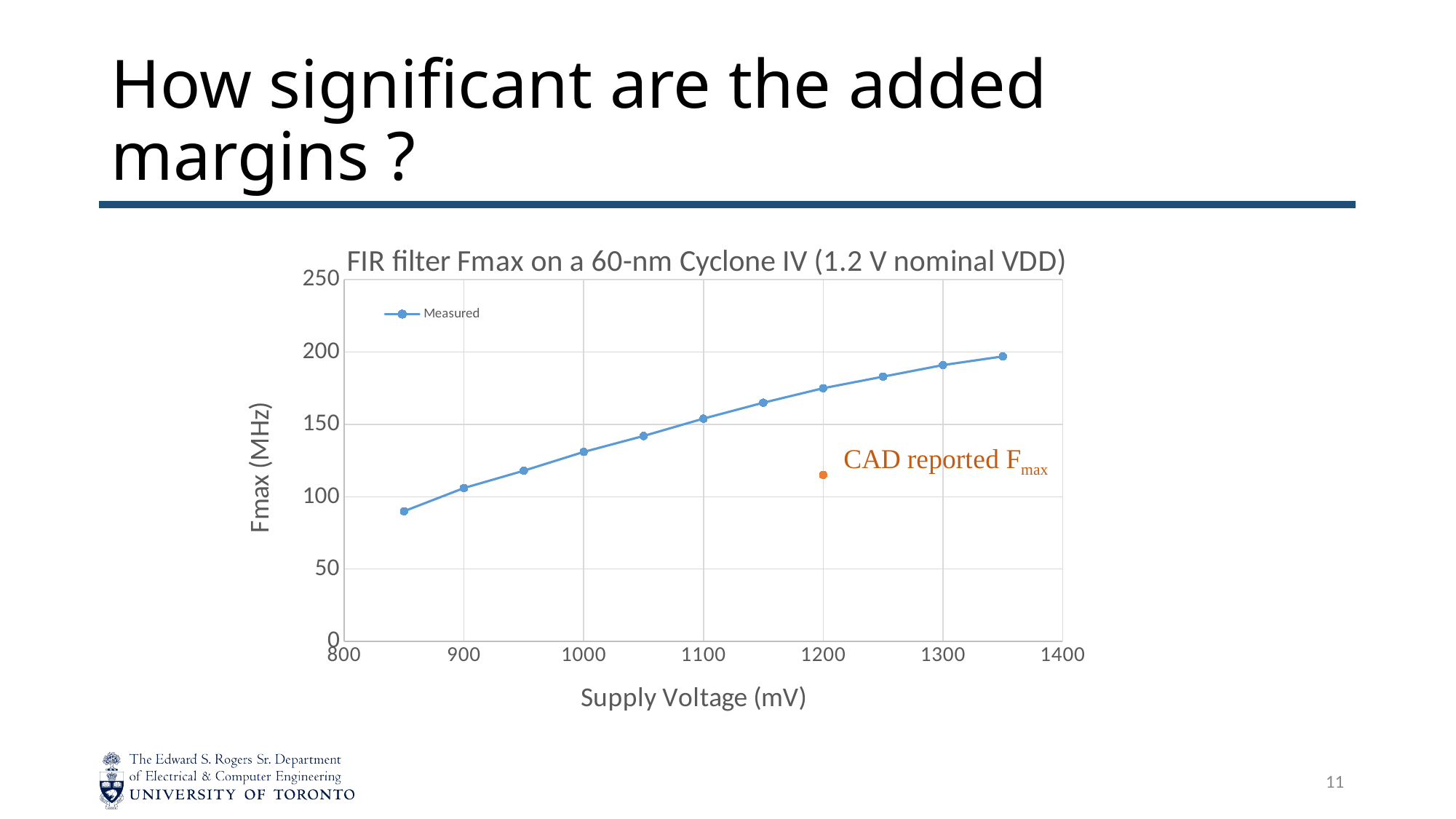
At which supply voltage is the measured Fmax highest? 1350 mV Is the CAD reported Fmax at 1200 mV greater or less than 150 MHz? less At which supply voltage is the measured Fmax lowest? 850 mV How many measured data points are plotted on the line? 11 What kind of chart is shown on the slide? line chart Is the measured Fmax at 850 mV greater or less than 100 MHz? less What is the title of the chart? FIR filter Fmax on a 60-nm Cyclone IV (1.2 V nominal VDD) Does the measured Fmax rise or fall as supply voltage increases? rises At 1200 mV, which is larger: the measured Fmax or the CAD reported Fmax? measured Fmax How many series does the chart legend list? 1